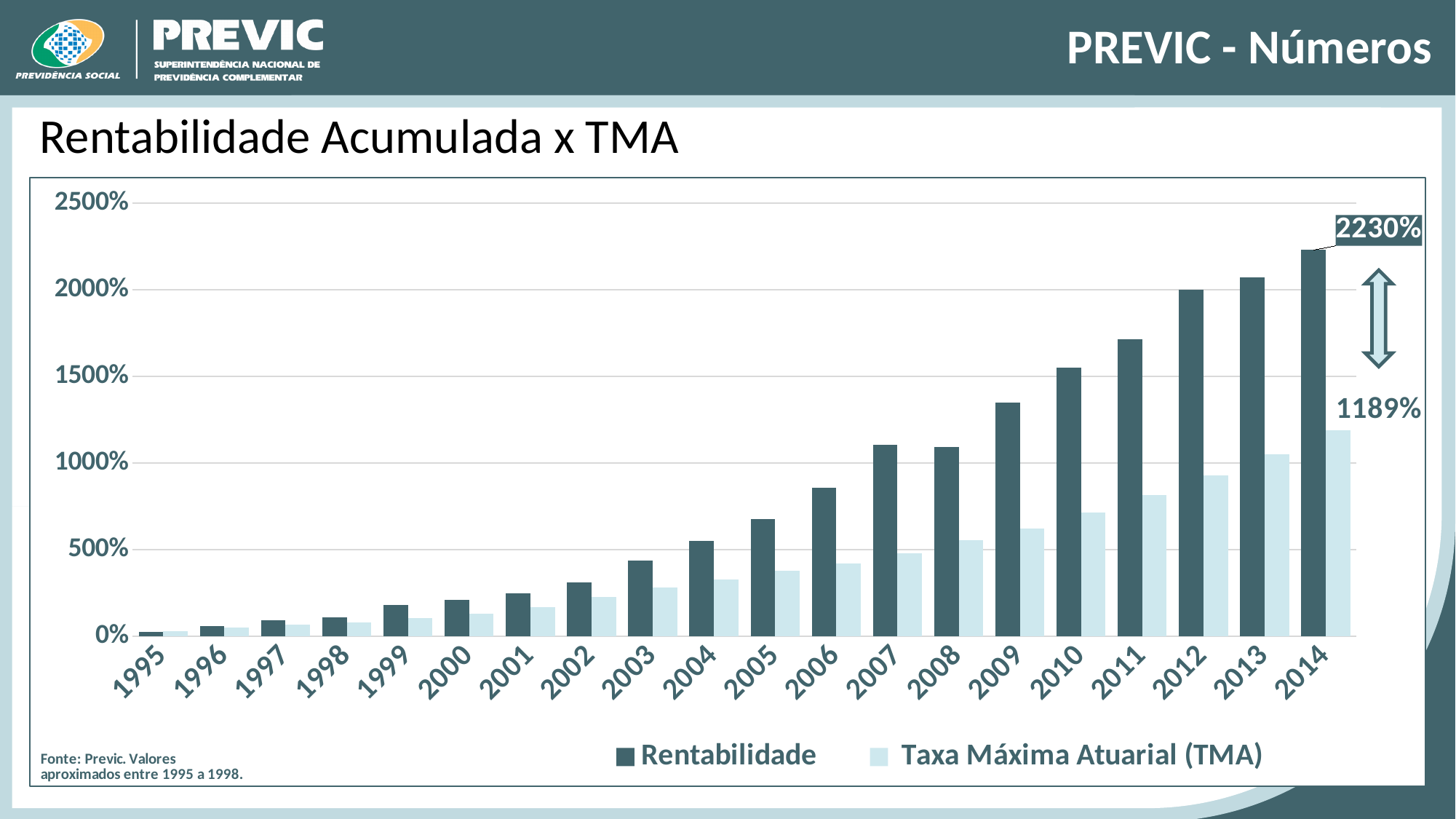
What kind of chart is shown on the slide? Bar chart Is the Taxa Máxima Atuarial (TMA) value for 2012 greater or less than 1000%? less In which year is the Rentabilidade bar highest? 2014 What is the difference between the Rentabilidade and the TMA values in 2014? 1041% How many series does the legend list? 2 What is the Rentabilidade value for 2014? 2230% How many years are shown on the x axis of the chart? 20 In which year is the Rentabilidade bar lowest? 1995 What is the Taxa Máxima Atuarial (TMA) value for 2014? 1189% In 2014, which is larger: Rentabilidade or Taxa Máxima Atuarial (TMA)? Rentabilidade Is the Rentabilidade value for 2012 greater or less than 1500%? greater Do the Rentabilidade values rise or fall from 1995 to 2014? Rise